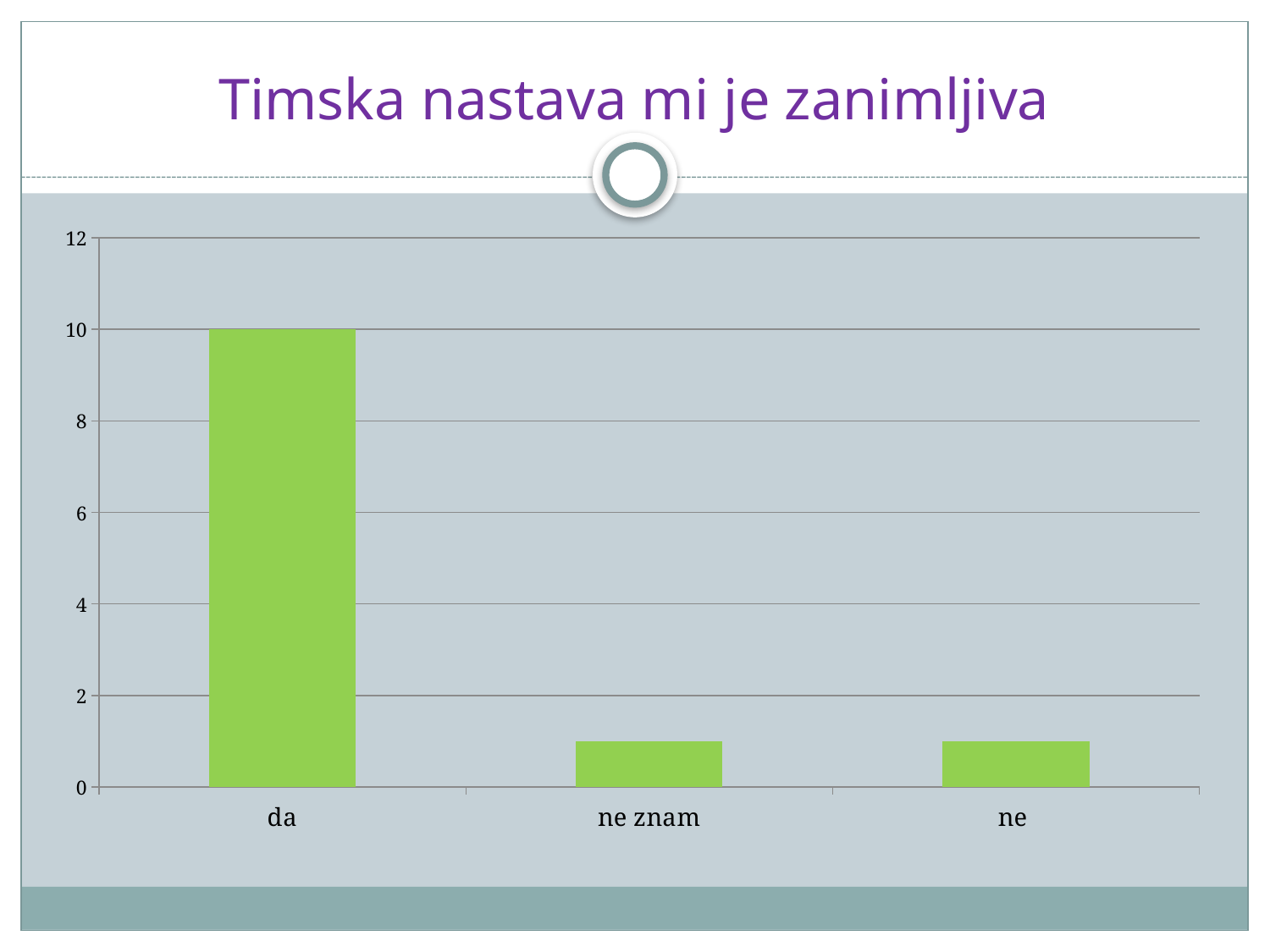
What is the value for "da"? 10 How many categories are shown on the x axis of the chart? 3 Is the value for "ne" greater or less than 2? less Is the value for "da" greater or less than 8? greater What is the title of the chart on the slide? Timska nastava mi je zanimljiva What is the highest value shown on the vertical axis? 12 Which category has the highest value? da Which is larger, the value for "da" or the value for "ne znam"? da What type of chart is shown on the slide? bar chart Which is larger, the value for "da" or the value for "ne"? da Is the value for "ne znam" greater or less than 2? less